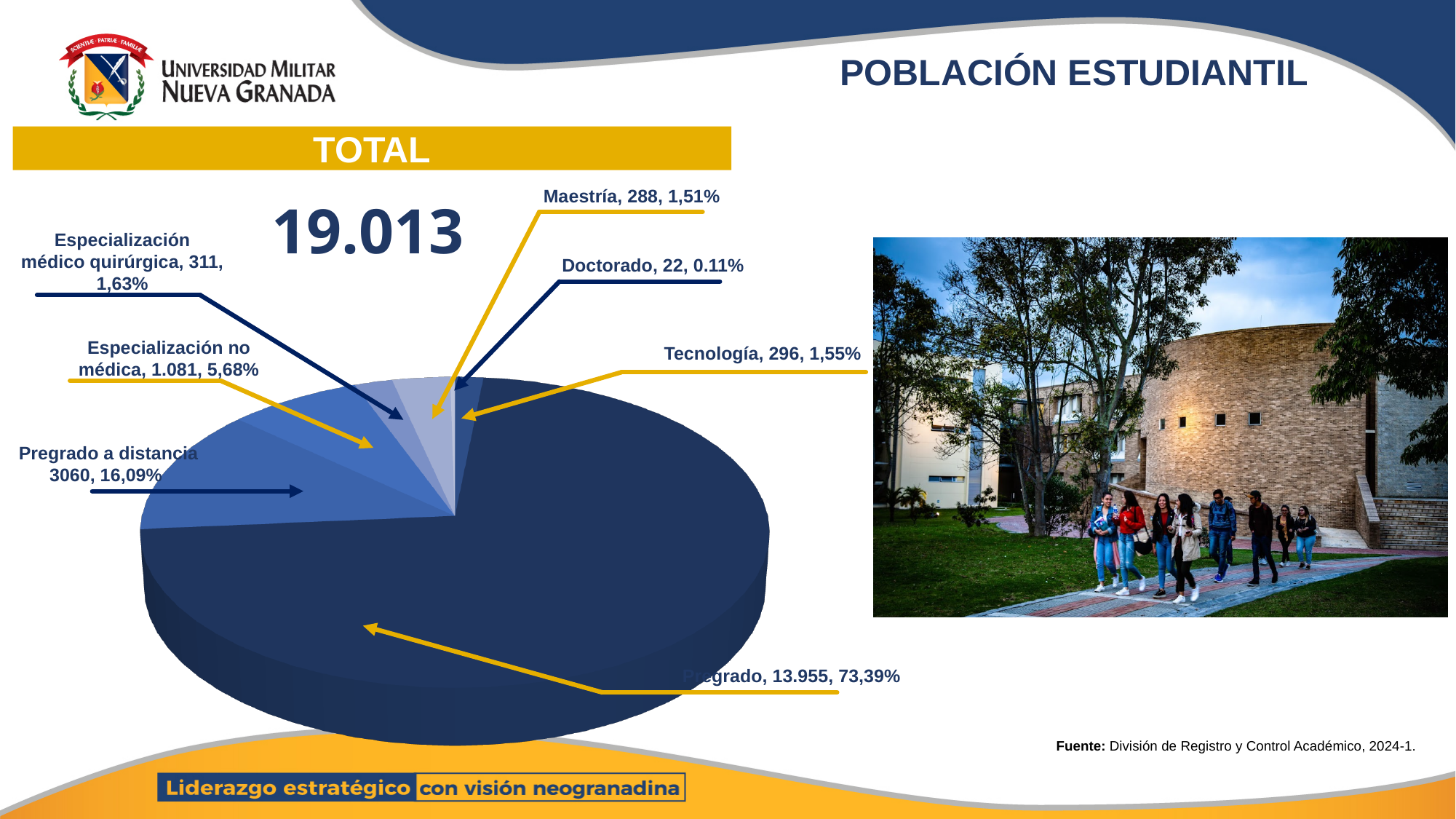
How many students are in the Pregrado a distancia category? 3060 What total number of students is shown above the pie chart? 19.013 What share of the pie does Pregrado represent? 73,39% How many categories does the pie chart show? 7 How many students are in the Doctorado category? 22 Which category has the largest slice of the pie? Pregrado Which category has the smallest slice of the pie? Doctorado Which has more students, Tecnología or Maestría? Tecnología What percentage is shown for Especialización no médica? 5,68% How many students are in the Pregrado category? 13.955 What kind of chart is shown on the slide? pie chart What is the difference between the number of students in Maestría and Doctorado? 266